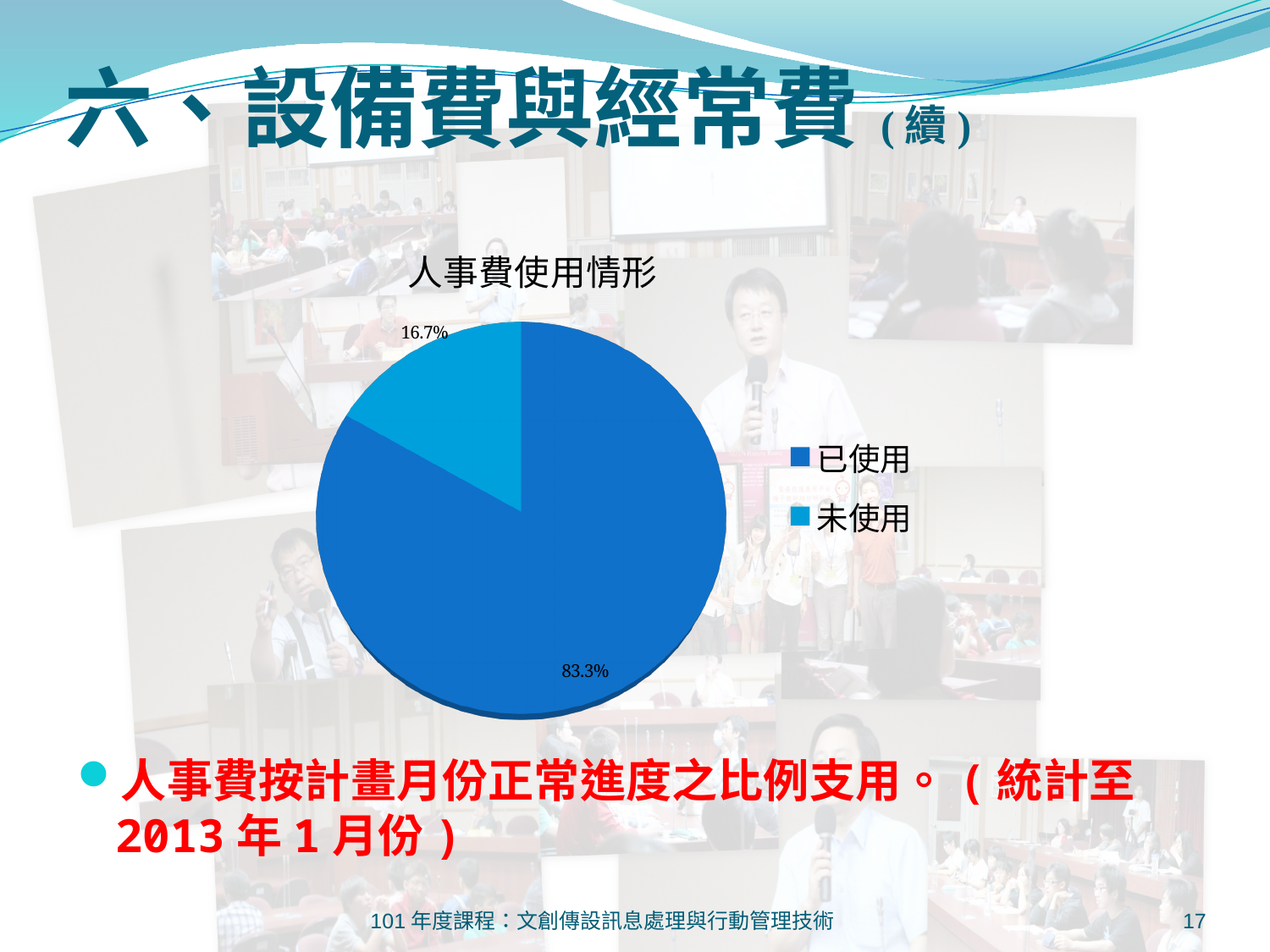
Which slice of the pie is the largest? 已使用 What percentage of the pie is labelled 已使用? 83.3% Which is larger, the 已使用 slice or the 未使用 slice? 已使用 How many entries does the legend list? 2 What is the difference in percentage points between 已使用 and 未使用? 66.6 What percentage of the pie is labelled 未使用? 16.7% Which legend entry is shown in the lighter blue colour? 未使用 What is the title of the chart? 人事費使用情形 How many slices does the pie chart have? 2 Which slice of the pie is the smallest? 未使用 What kind of chart is shown on the slide? pie chart